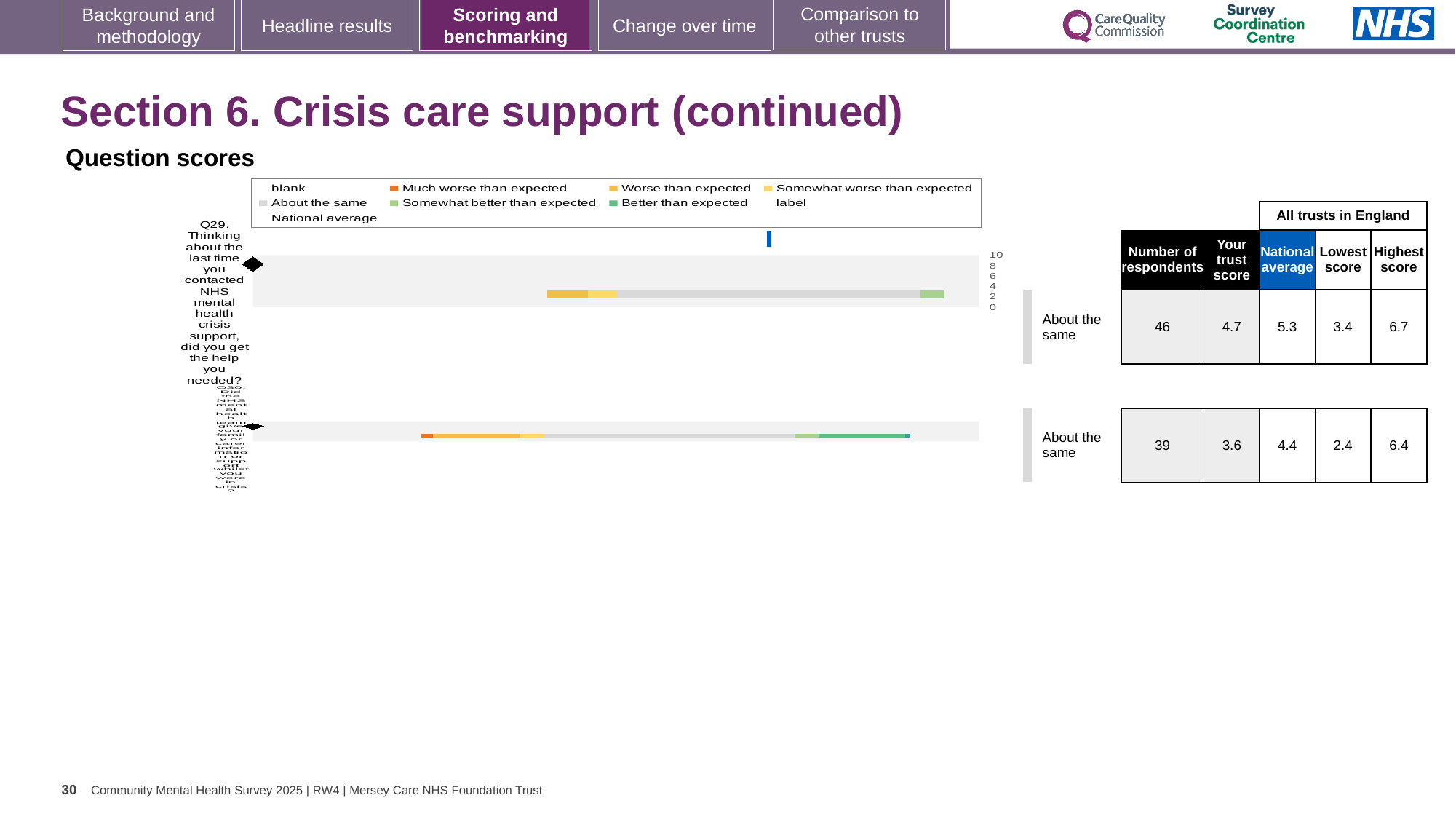
Which is larger for Q29: the trust score or the national average? national average What is the highest value shown on the chart's numeric axis? 10 What kind of chart is shown under "Question scores"? bar chart What is the difference between the national average and the trust score for Q30? 0.8 What benchmark category is shown for Q29 next to the chart? About the same Which legend entry is represented by the orange-red colour in the chart? Much worse than expected Which question has the higher "Highest score" value, Q29 or Q30? Q29 What is the national average for Q30 in the table beside the chart? 4.4 What is the trust score for Q29 in the table beside the chart? 4.7 How many respondents answered Q29? 46 How many questions (bars) are plotted in the chart? 2 What is the lowest score among all trusts in England for Q30? 2.4